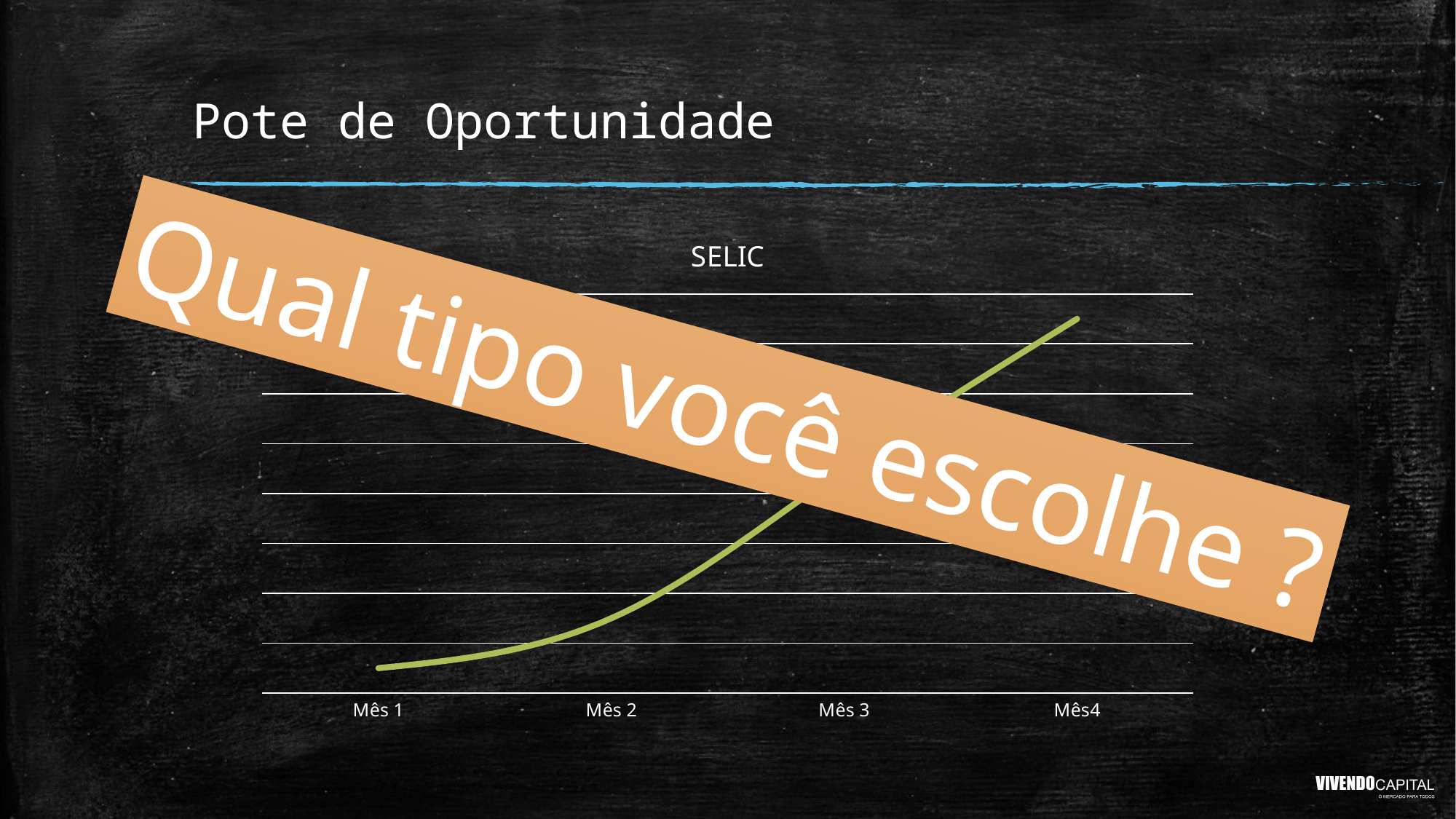
In the SELIC chart, which is larger, the value for Mês 1 or the value for Mês4? Mês4 What is the title of the chart? SELIC In the SELIC chart, which is larger, the value for Mês 2 or the value for Mês 3? Mês 3 Do the values in the SELIC chart rise or fall from Mês 1 to Mês4? rise Which month has the lowest value in the SELIC chart? Mês 1 Which month has the highest value in the SELIC chart? Mês4 What kind of chart is shown on the slide? line chart How many categories are shown on the x axis of the SELIC chart? 4 What is the label of the first category on the x axis of the SELIC chart? Mês 1